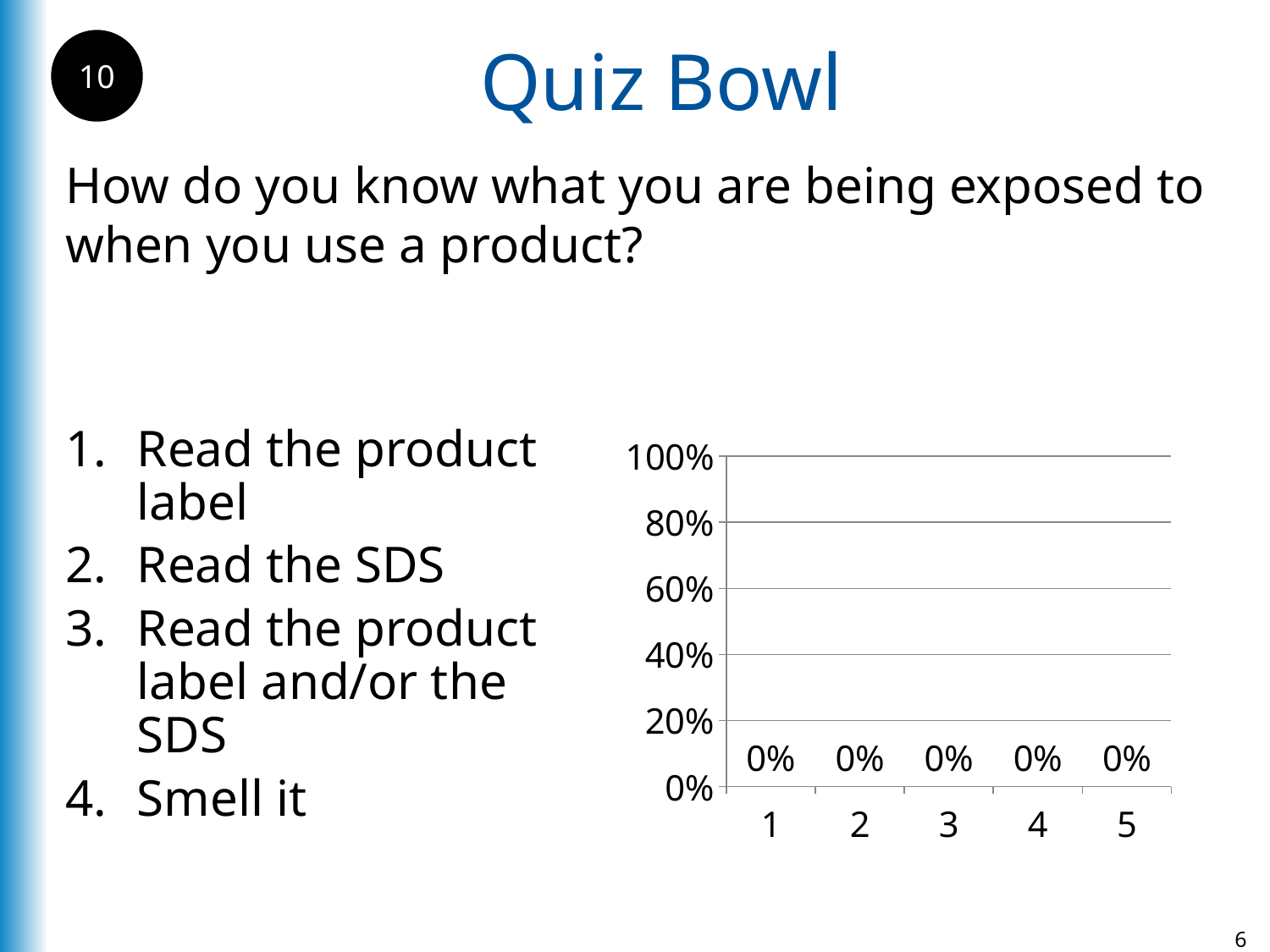
Do the values rise, fall, or stay the same from category 1 to category 5? stay the same What is the value shown for category 5? 0% What is the value shown for category 2? 0% What is the difference between the values for category 1 and category 4? 0% What is the value shown for category 4? 0% What kind of chart is shown on the slide? bar chart How many categories are shown on the x axis of the chart? 5 What is the value shown for category 3? 0% Is the value for category 3 greater or less than 20%? less What is the highest value labelled on the vertical axis of the chart? 100% What is the value shown for category 1? 0% Is the value for category 5 greater or less than 40%? less